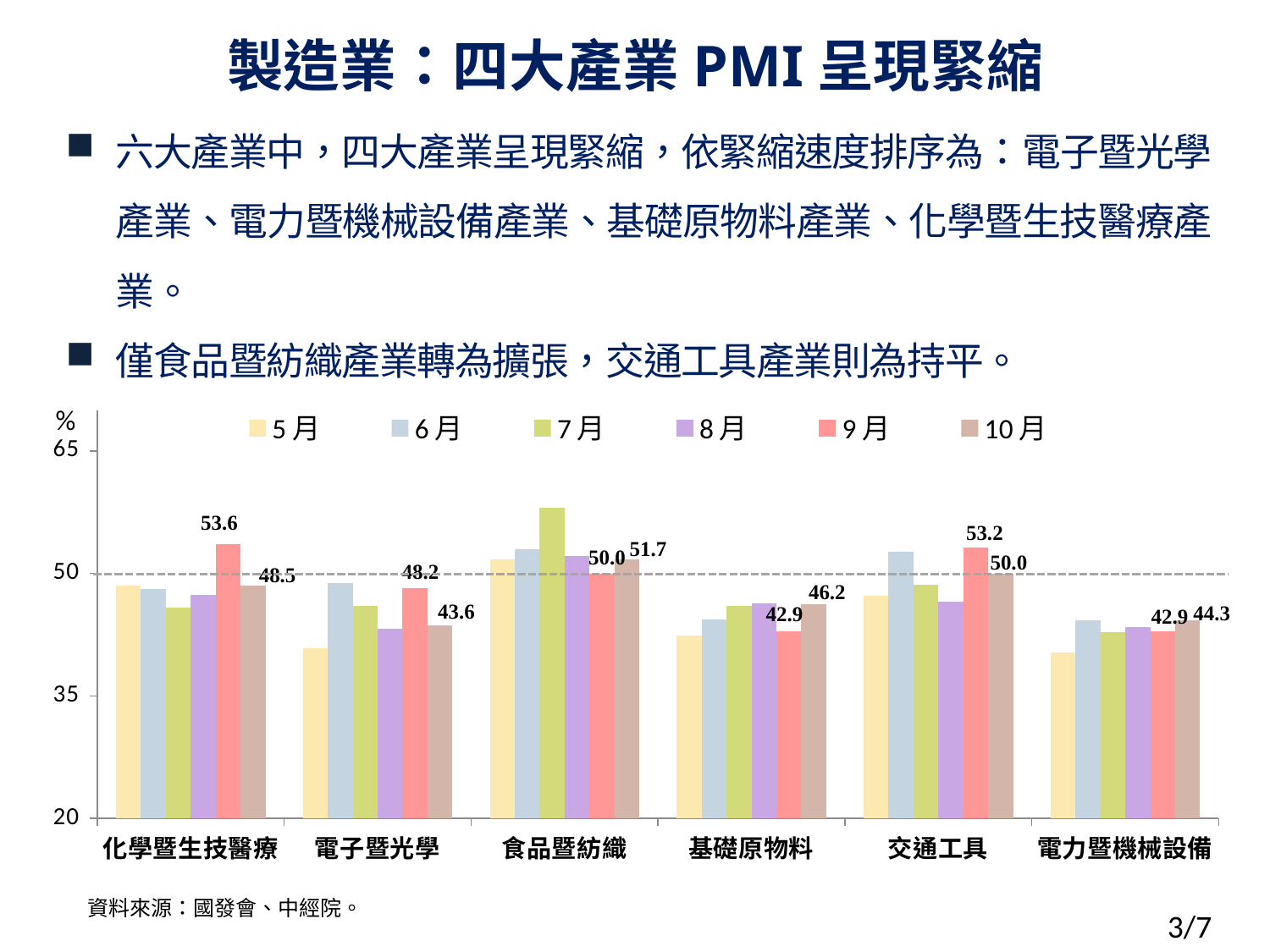
Which category has the highest 9月 value? 化學暨生技醫療 What is the 10月 value for 電力暨機械設備? 44.3 How many series does the legend list? 6 Which category has the highest 10月 value? 食品暨紡織 Is the 7月 value for 食品暨紡織 greater or less than 50? greater What is the difference between the 10月 and 9月 values for 基礎原物料? 3.3 Which is larger for 交通工具: the 9月 value or the 10月 value? 9月 How many industry categories are shown on the x axis? 6 What is the difference between the 9月 and 10月 values for 化學暨生技醫療? 5.1 Is the 5月 value for 電子暨光學 greater or less than 50? less What is the 10月 value for 食品暨紡織? 51.7 What is the 9月 value for 化學暨生技醫療? 53.6